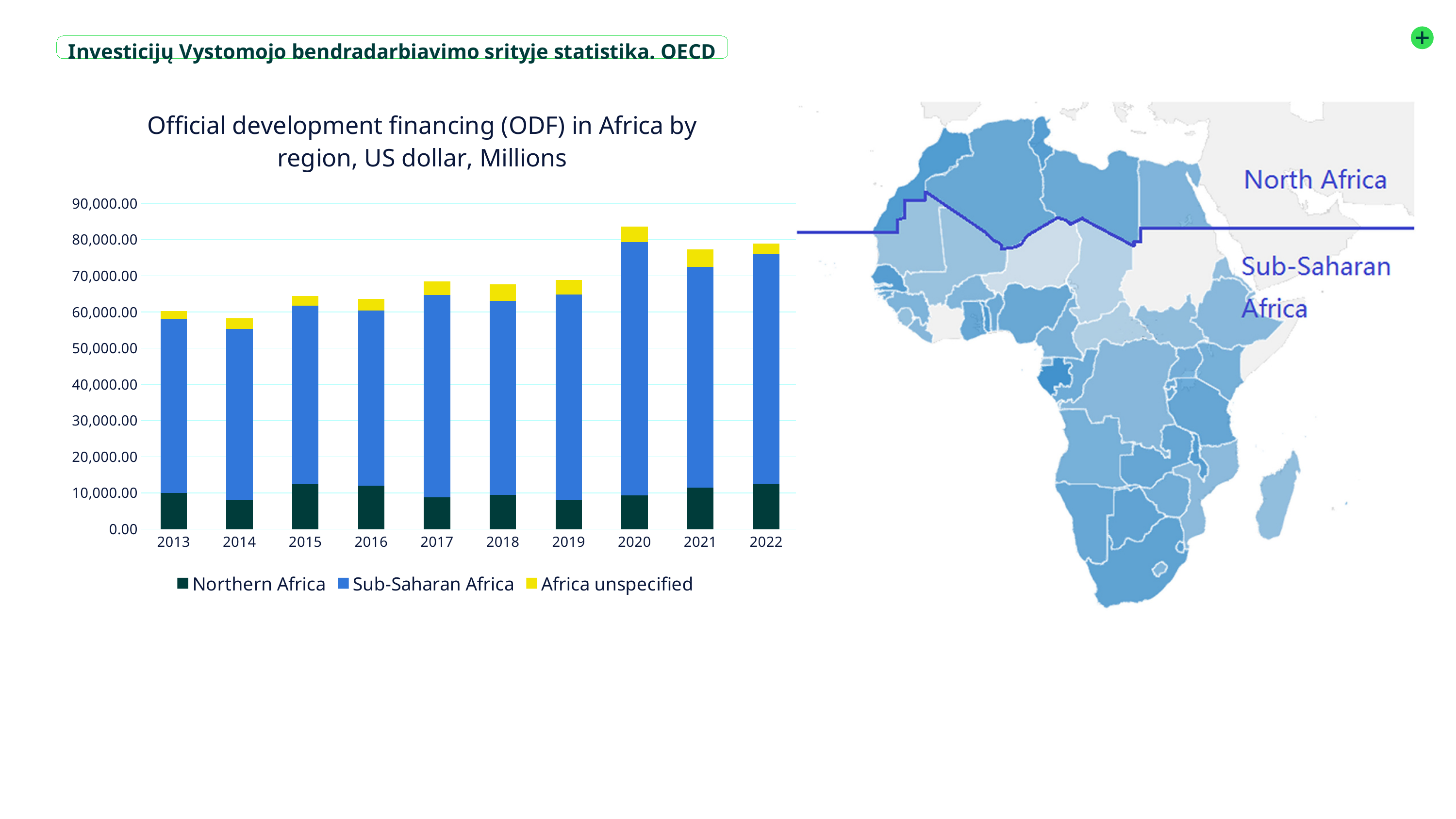
What colour represents the 'Africa unspecified' series in the chart? Yellow Is the total value for 2014 greater or less than 60,000.00? less Which year has the lowest total official development financing in the chart? 2014 How many years are shown on the x axis of the chart? 10 Does the total official development financing generally rise or fall from 2013 to 2022? rise Is the Northern Africa value for 2014 greater or less than 10,000.00? less Which year has the larger total official development financing, 2020 or 2021? 2020 What kind of chart is shown on the slide? Stacked bar chart Is the total value for 2020 greater or less than 80,000.00? greater How many series does the chart's legend list? 3 Which year has the highest total official development financing in the chart? 2020